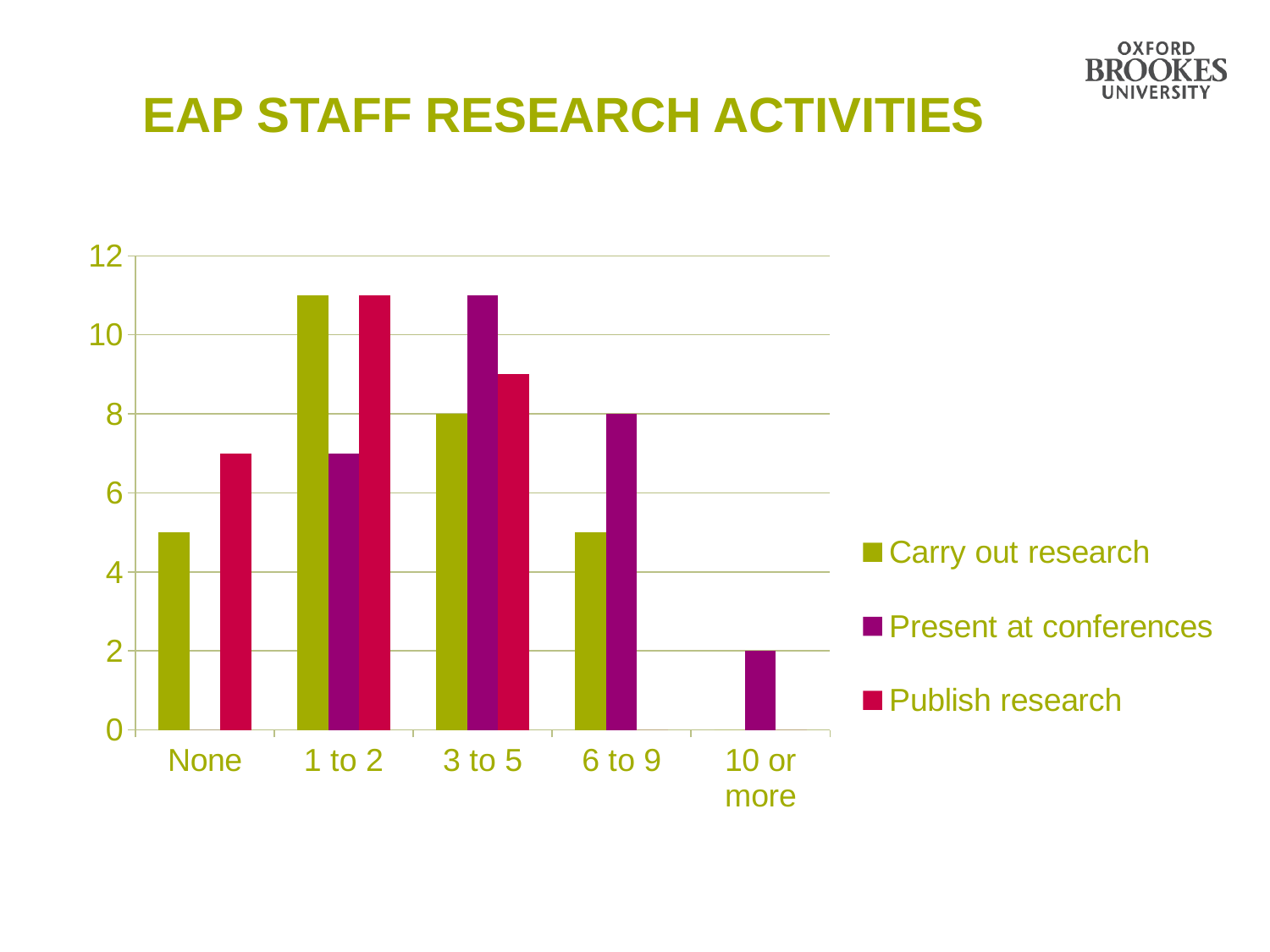
How many series does the legend list? 3 In the 1 to 2 category, which is larger: Present at conferences or Publish research? Publish research What is the value for Present at conferences in the 10 or more category? 2 What is the value for Carry out research in the 3 to 5 category? 8 Is the value for Publish research in the None category greater or less than 6? greater What is the title of the chart? EAP STAFF RESEARCH ACTIVITIES How many categories are shown on the x axis? 5 What is the value for Present at conferences in the 6 to 9 category? 8 In the None category, which is larger: Carry out research or Publish research? Publish research Which category has the highest value for Present at conferences? 3 to 5 Is the value for Carry out research in the 1 to 2 category greater or less than 10? greater What kind of chart is shown on the slide? bar chart